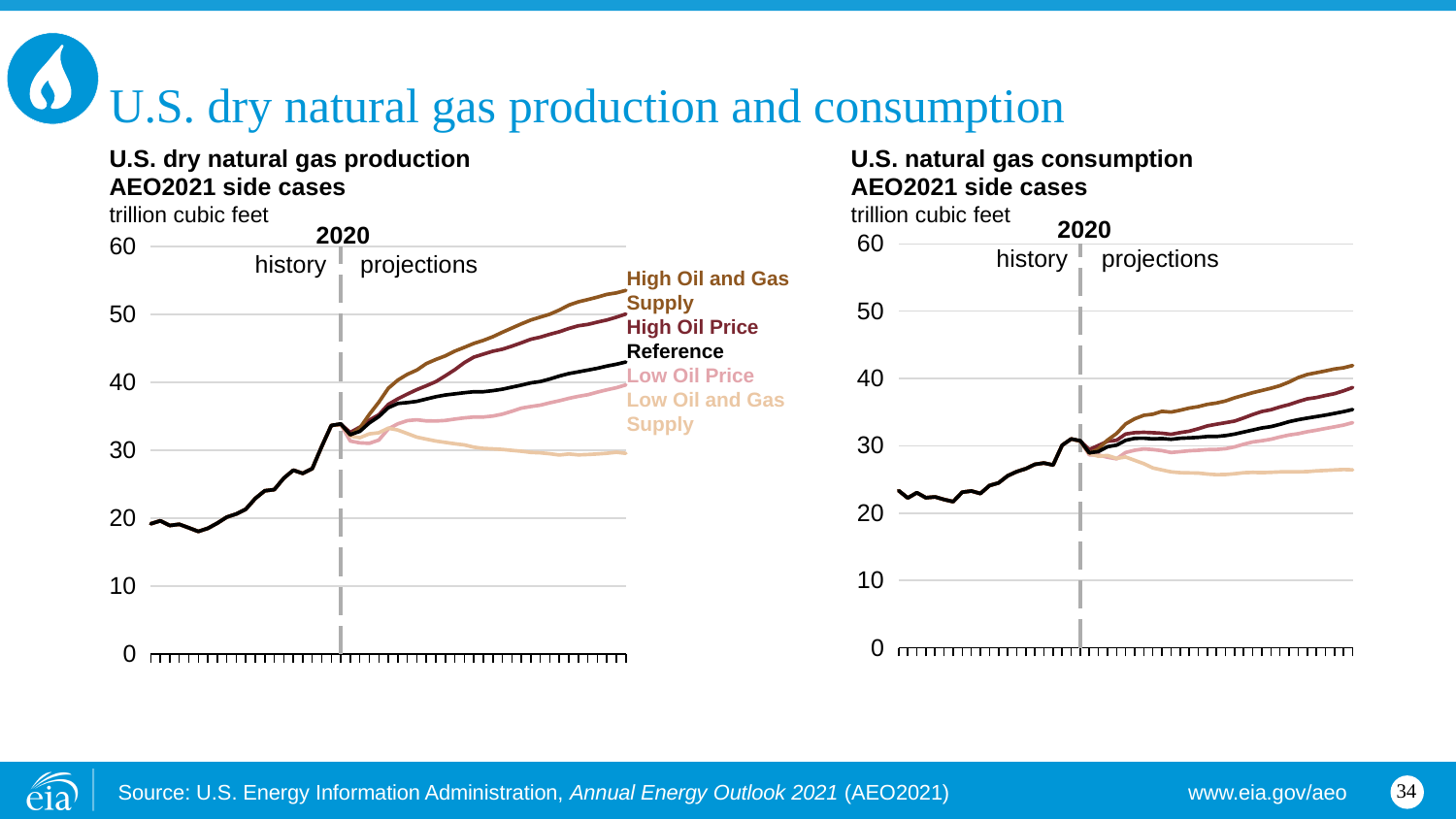
How many series are labelled on the U.S. dry natural gas production chart on the left? 5 On the U.S. natural gas consumption chart on the right, does the lowest (lightest) series rise or fall over the projection period? fall What kind of chart is the U.S. dry natural gas production chart on the left? line chart On the U.S. dry natural gas production chart, which series is highest at the end of the projection period? High Oil and Gas Supply On the U.S. dry natural gas production chart, is the High Oil and Gas Supply value at the end of the projections greater or less than 50? greater On the U.S. natural gas consumption chart on the right, is the highest series at the end of the projections greater or less than 40? greater On the U.S. dry natural gas production chart, is the Reference value at the end of the projections greater or less than 40? greater On the U.S. dry natural gas production chart, which series is lowest at the end of the projection period? Low Oil and Gas Supply On the U.S. dry natural gas production chart, which is larger at the end of the projections, High Oil Price or Low Oil Price? High Oil Price What unit is used on the vertical axis of both charts? trillion cubic feet What year does the dashed vertical line separating history from projections mark on both charts? 2020